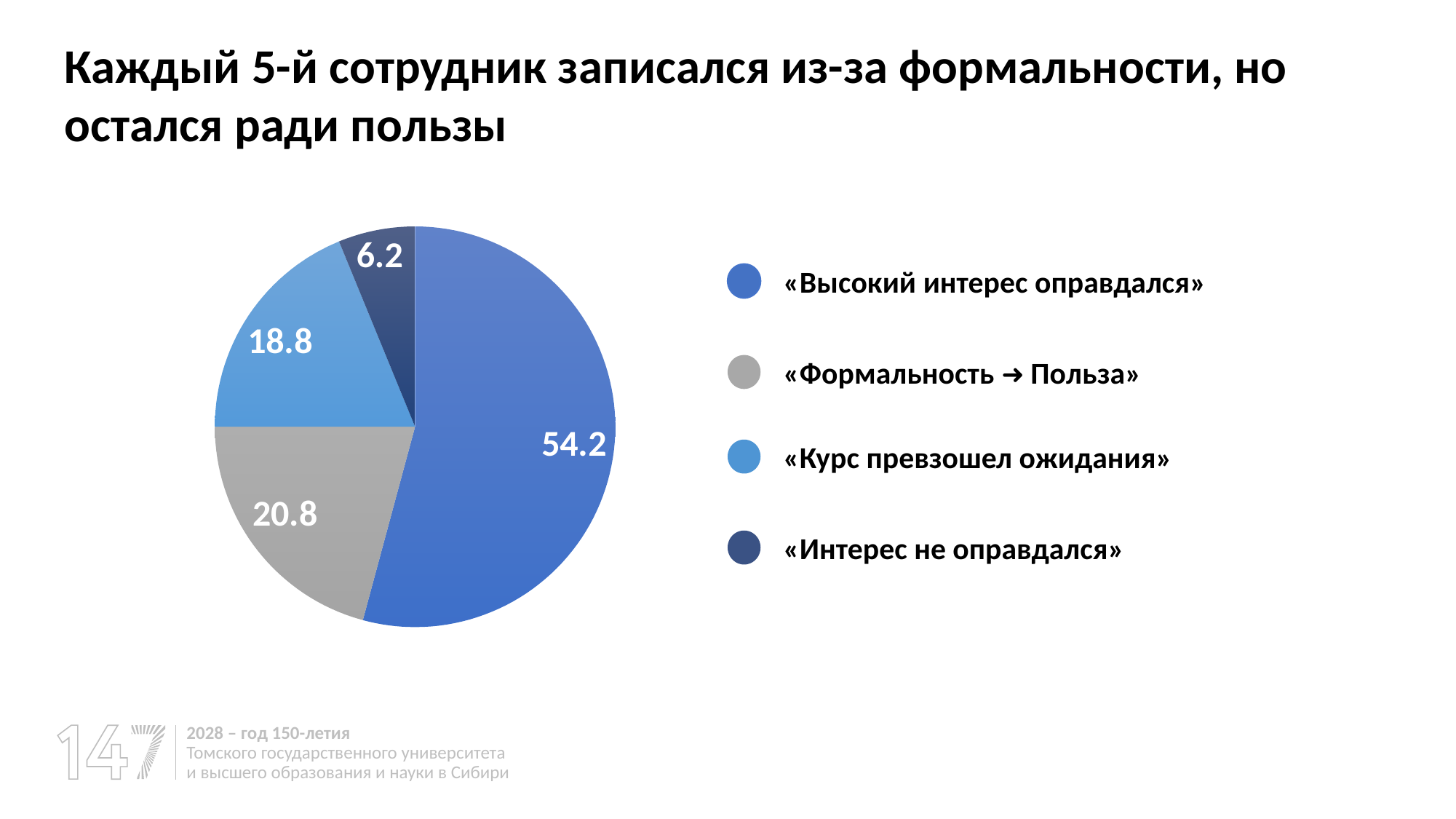
What is the difference between the values for «Высокий интерес оправдался» and «Формальность → Польза»? 33.4 What kind of chart is shown on the slide? pie chart What colour is the slice for «Формальность → Польза»? grey Which category has the largest slice? «Высокий интерес оправдался» What is the difference between the values for «Курс превзошел ожидания» and «Интерес не оправдался»? 12.6 What is the value for «Интерес не оправдался»? 6.2 What is the value for «Высокий интерес оправдался»? 54.2 How many slices does the pie chart have? 4 Which category has the smallest slice? «Интерес не оправдался» What is the value for «Курс превзошел ожидания»? 18.8 Which is larger, «Формальность → Польза» or «Курс превзошел ожидания»? «Формальность → Польза» What is the value for «Формальность → Польза»? 20.8